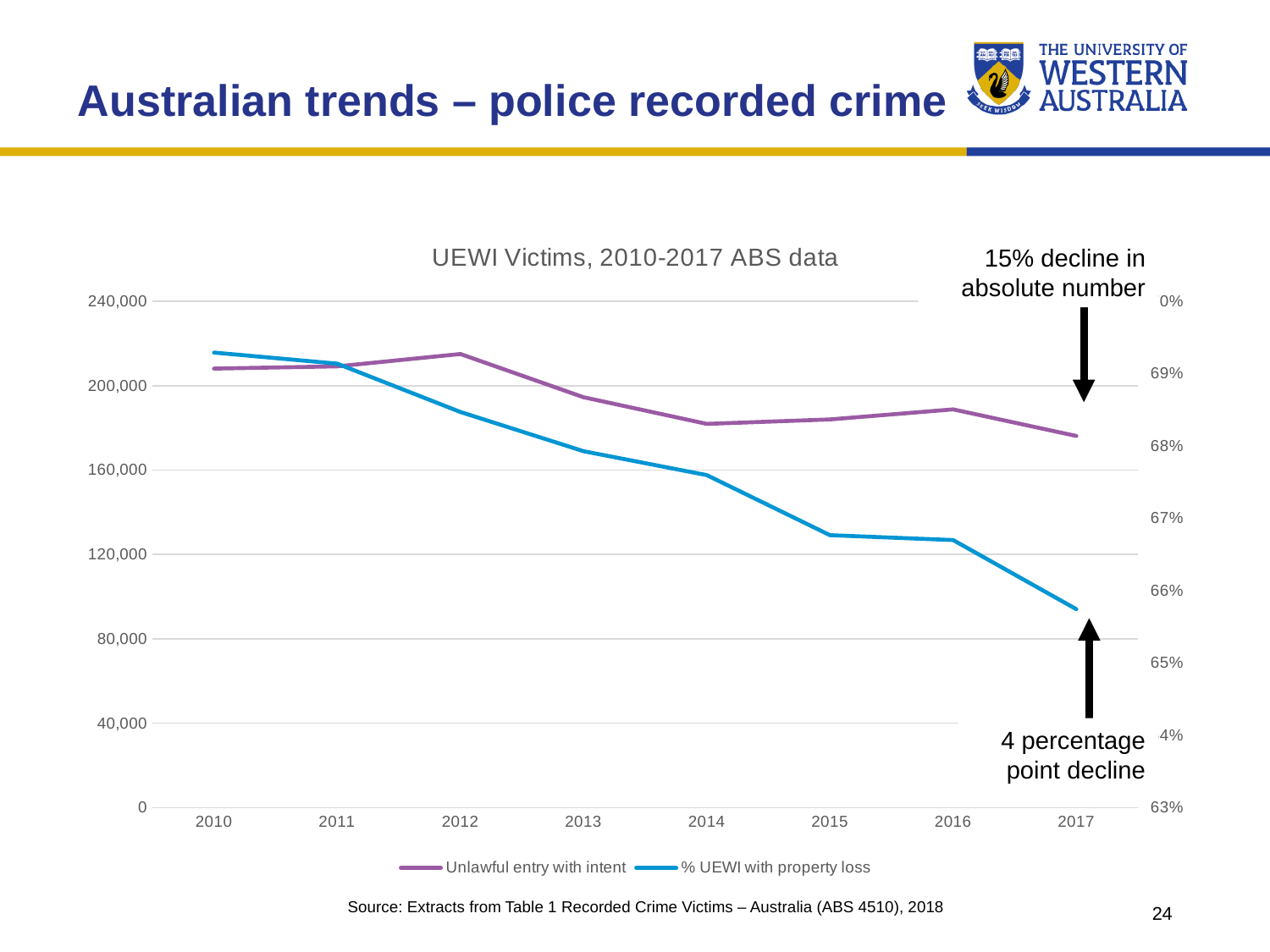
Which year has the highest value for % UEWI with property loss? 2010 Is the value for % UEWI with property loss in 2017 greater or less than 66%? less Does the % UEWI with property loss series generally rise or fall from 2010 to 2017? Fall What kind of chart is shown on the slide? Line chart Which series is larger in 2017, Unlawful entry with intent or % UEWI with property loss, in terms of position on the chart? Unlawful entry with intent Is the value for Unlawful entry with intent in 2017 greater or less than 200,000? less How many years are plotted along the x axis? 8 Which year has the lowest value for % UEWI with property loss? 2017 What is the title of the chart? UEWI Victims, 2010-2017 ABS data Which year has the lowest value for Unlawful entry with intent? 2017 How many series does the legend list? 2 Is the value for Unlawful entry with intent in 2010 greater or less than 200,000? greater